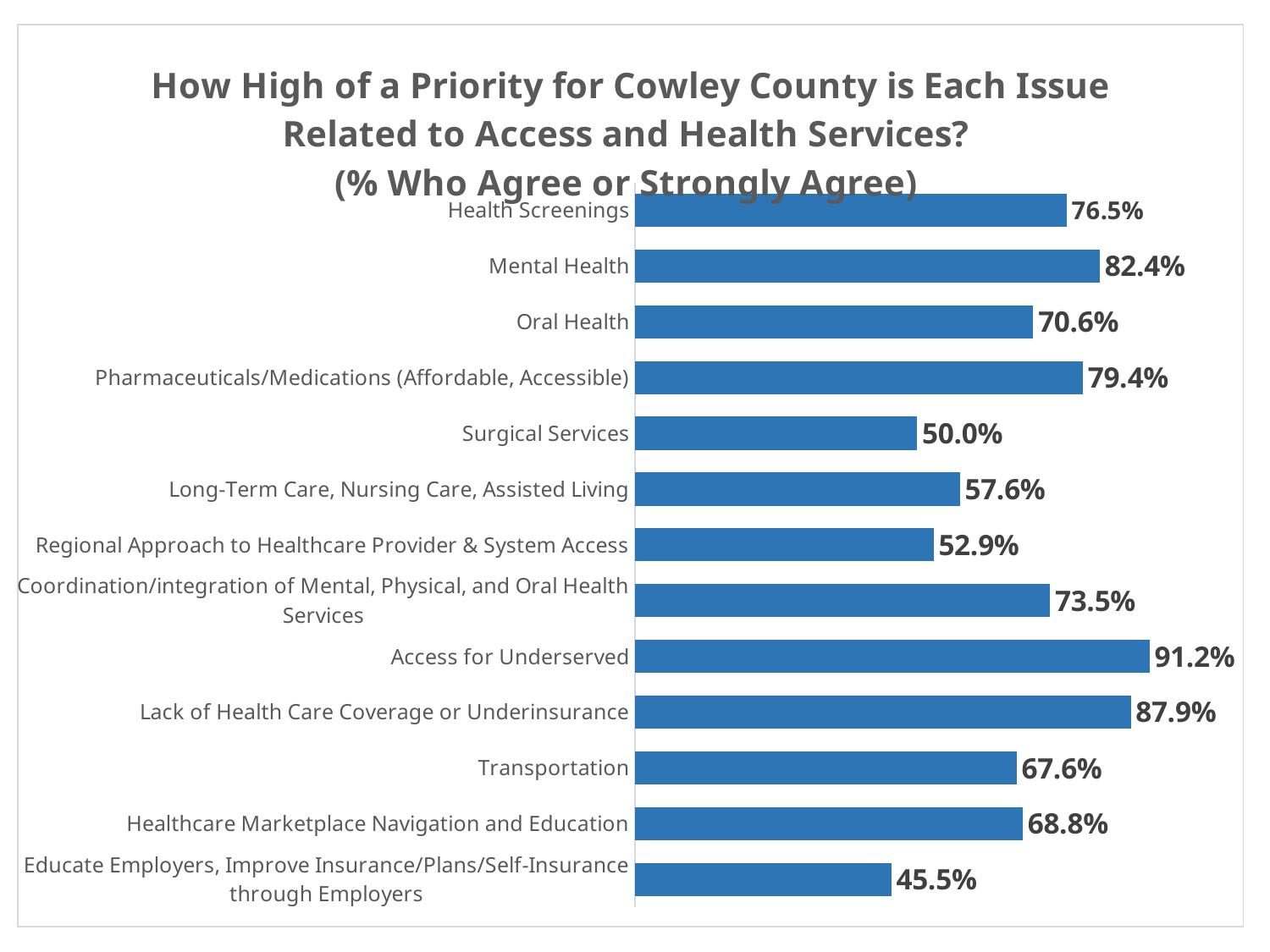
How many issues are shown in the chart? 13 What is the difference between the values for Pharmaceuticals/Medications (Affordable, Accessible) and Surgical Services? 29.4% Which issue has the lowest percentage of agreement? Educate Employers, Improve Insurance/Plans/Self-Insurance through Employers What is the value shown for Surgical Services? 50.0% What kind of chart is shown on the slide? Bar chart Which has a higher value, Health Screenings or Oral Health? Health Screenings Which issue has the highest percentage of agreement? Access for Underserved Which has a higher value, Long-Term Care, Nursing Care, Assisted Living or Regional Approach to Healthcare Provider & System Access? Long-Term Care, Nursing Care, Assisted Living What colour are the bars in the chart? Blue What percentage agree or strongly agree that Mental Health is a high priority? 82.4% What is the difference between the values for Access for Underserved and Lack of Health Care Coverage or Underinsurance? 3.3% What is the value shown for Transportation? 67.6%